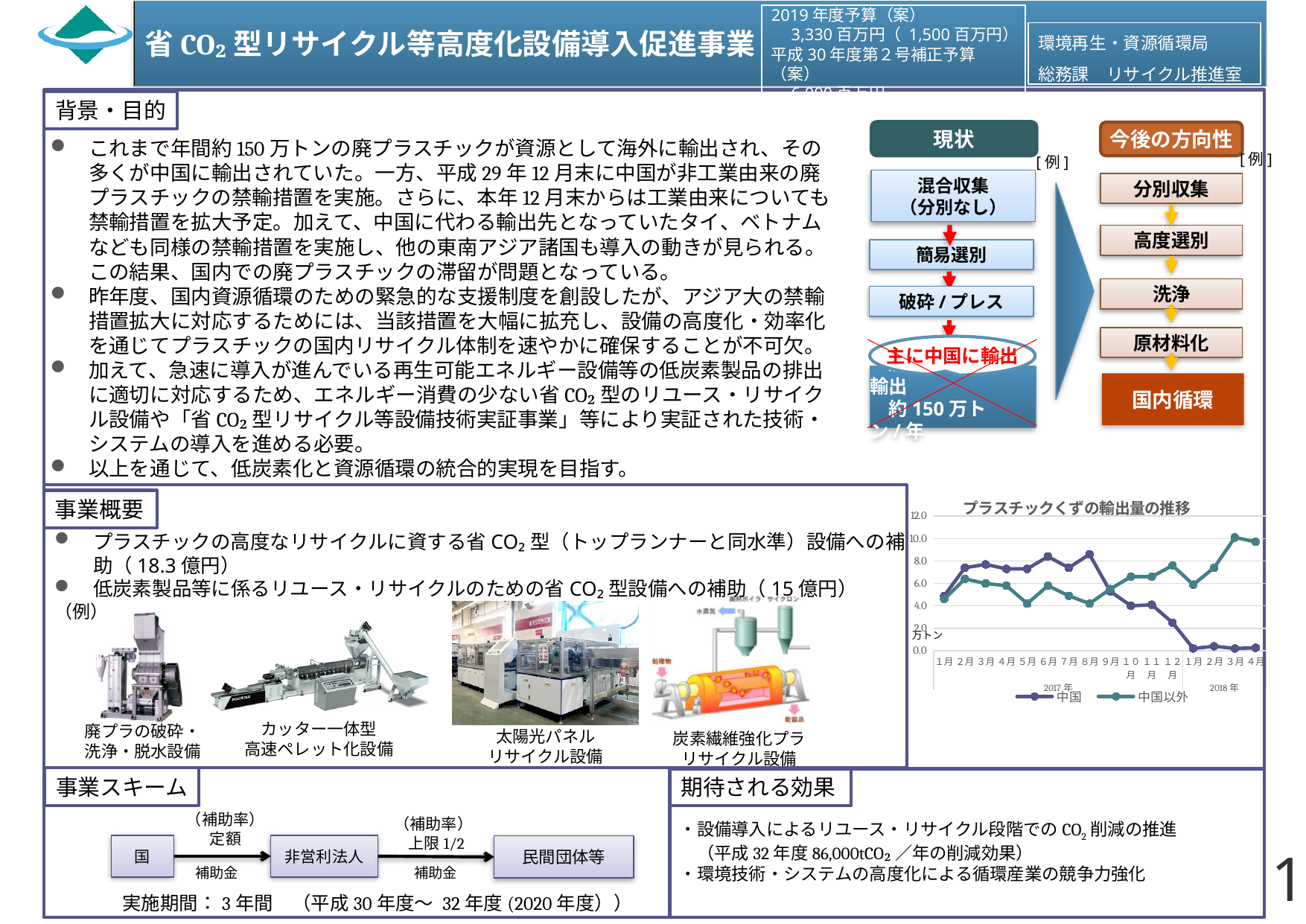
In the chart 'プラスチックくずの輸出量の推移', is the value for 中国以外 in 2018年3月 greater or less than 8.0? greater How many series does the legend of the chart 'プラスチックくずの輸出量の推移' list? 2 In the chart 'プラスチックくずの輸出量の推移', is the value for 中国以外 in 2017年5月 greater or less than 6.0? less In the chart 'プラスチックくずの輸出量の推移', which series has the larger value in 2017年6月, 中国 or 中国以外? 中国 In the chart 'プラスチックくずの輸出量の推移', does the 中国以外 series rise or fall overall from 2017年1月 to 2018年4月? rise In the chart 'プラスチックくずの輸出量の推移', is the value for 中国 in 2018年1月 greater or less than 2.0? less What kind of chart is 'プラスチックくずの輸出量の推移'? line chart How many monthly points are plotted along the x axis of the chart 'プラスチックくずの輸出量の推移'? 16 In the chart 'プラスチックくずの輸出量の推移', does the 中国 series rise or fall overall from 2017年1月 to 2018年4月? fall In the chart 'プラスチックくずの輸出量の推移', which series has the larger value in 2018年4月, 中国 or 中国以外? 中国以外 What are the two series named in the legend of the chart 'プラスチックくずの輸出量の推移'? 中国, 中国以外